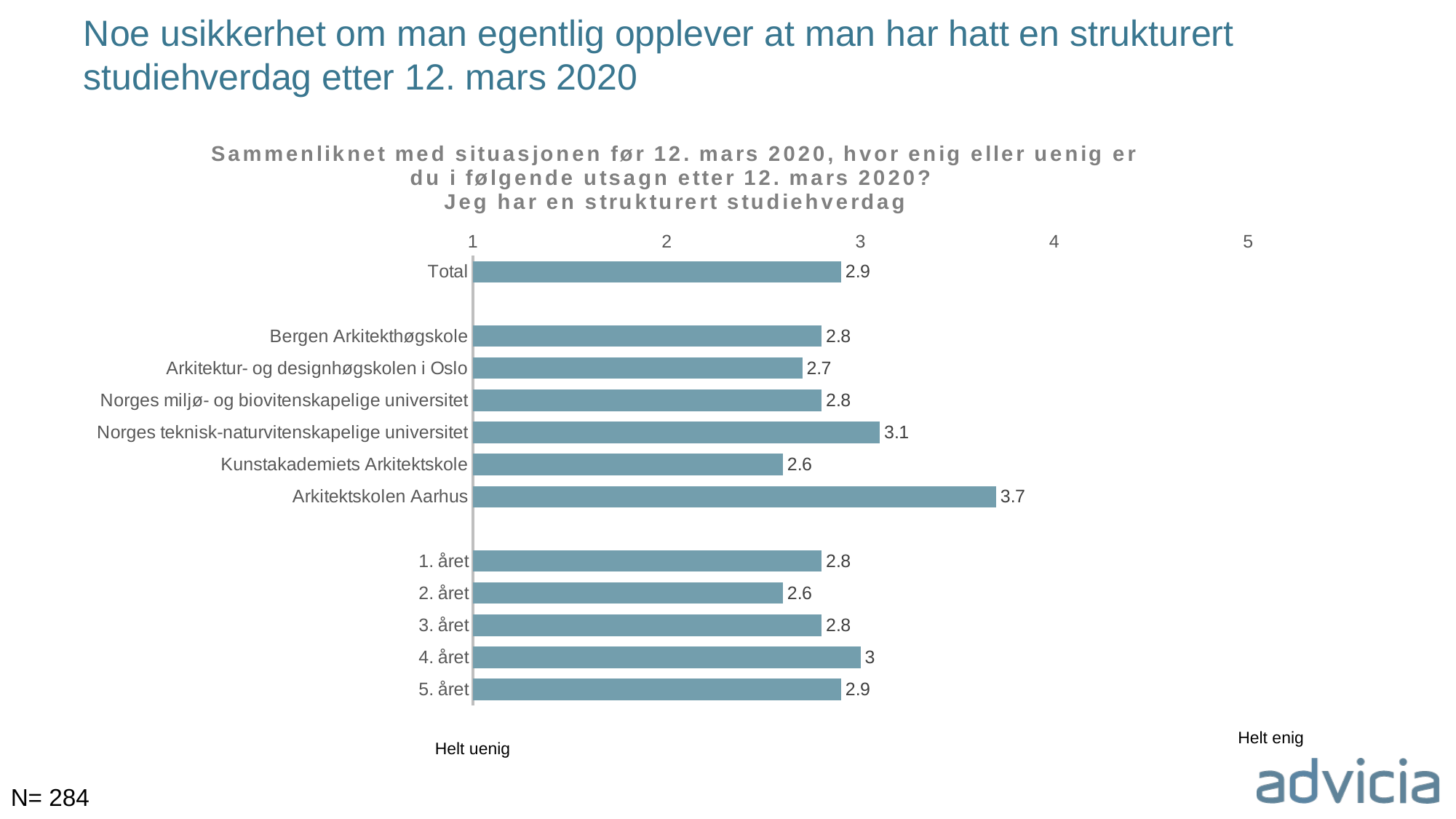
What is the value for Norges teknisk-naturvitenskapelige universitet? 3.1 Which is larger, the value for Arkitektur- og designhøgskolen i Oslo or the value for Norges teknisk-naturvitenskapelige universitet? Norges teknisk-naturvitenskapelige universitet What is the value for Total? 2.9 What is the value for Arkitektskolen Aarhus? 3.7 How many categories are plotted in the chart? 12 Which category has the highest value? Arkitektskolen Aarhus What label appears at the right end of the axis, under the value 5? Helt enig What kind of chart is shown on the slide? bar chart What is the value for 4. året? 3 What is the difference between the values for 4. året and 2. året? 0.4 Is the value for Arkitektskolen Aarhus greater or less than 3? greater What is the difference between the values for Arkitektskolen Aarhus and Kunstakademiets Arkitektskole? 1.1